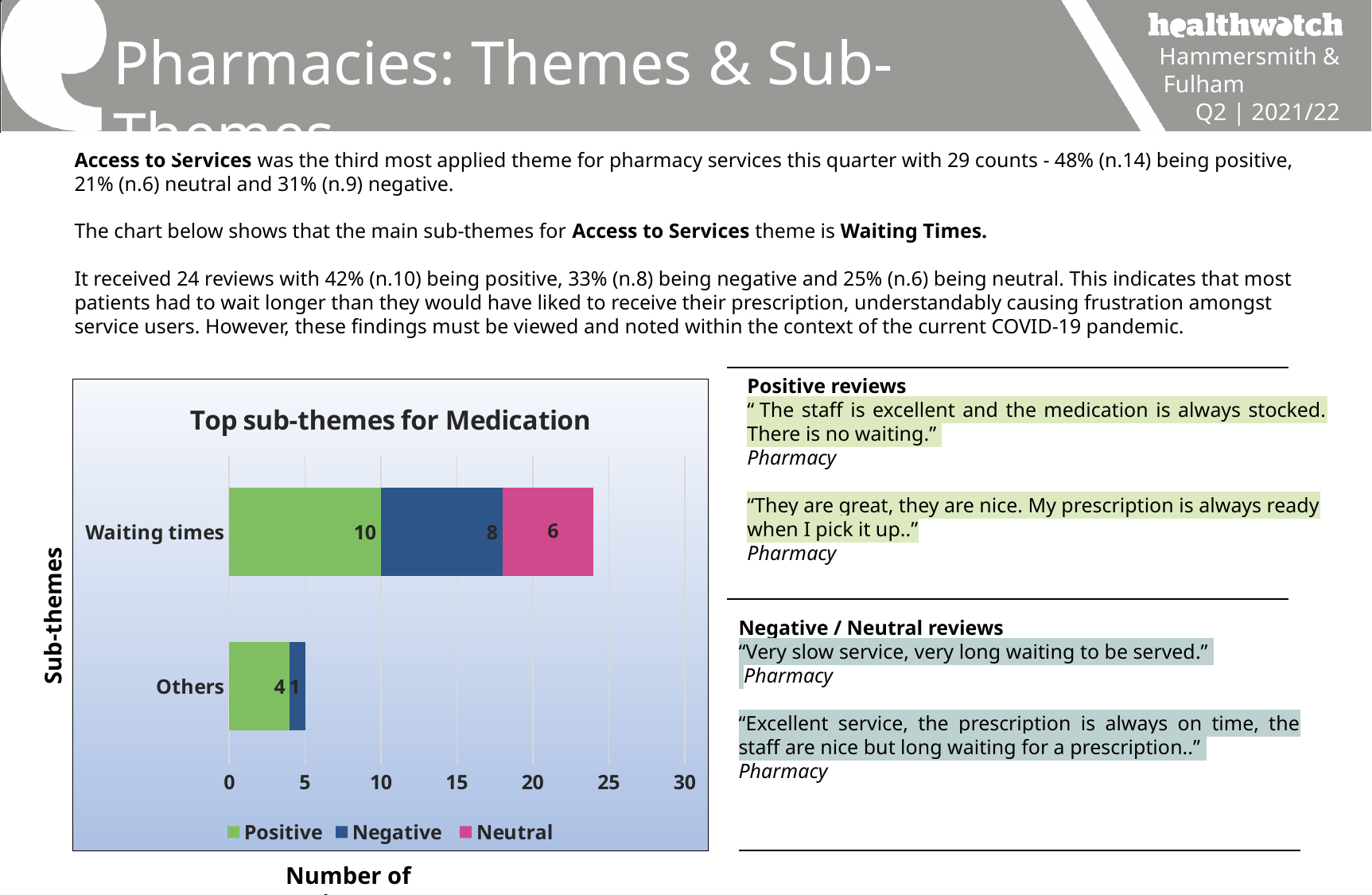
How many sub-theme categories are plotted in the chart? 2 What is the Negative value for Others? 1 What is the Negative value for Waiting times? 8 What type of chart is shown on the slide? Stacked bar chart Which sub-theme has the longer bar overall, Waiting times or Others? Waiting times What is the Positive value for Others? 4 What is the title of the chart? Top sub-themes for Medication How many series does the chart legend list? 3 What is the Positive value for Waiting times? 10 What is the total of the stacked bar for Waiting times? 24 What is the Neutral value for Waiting times? 6 What is the difference between the Positive values for Waiting times and Others? 6